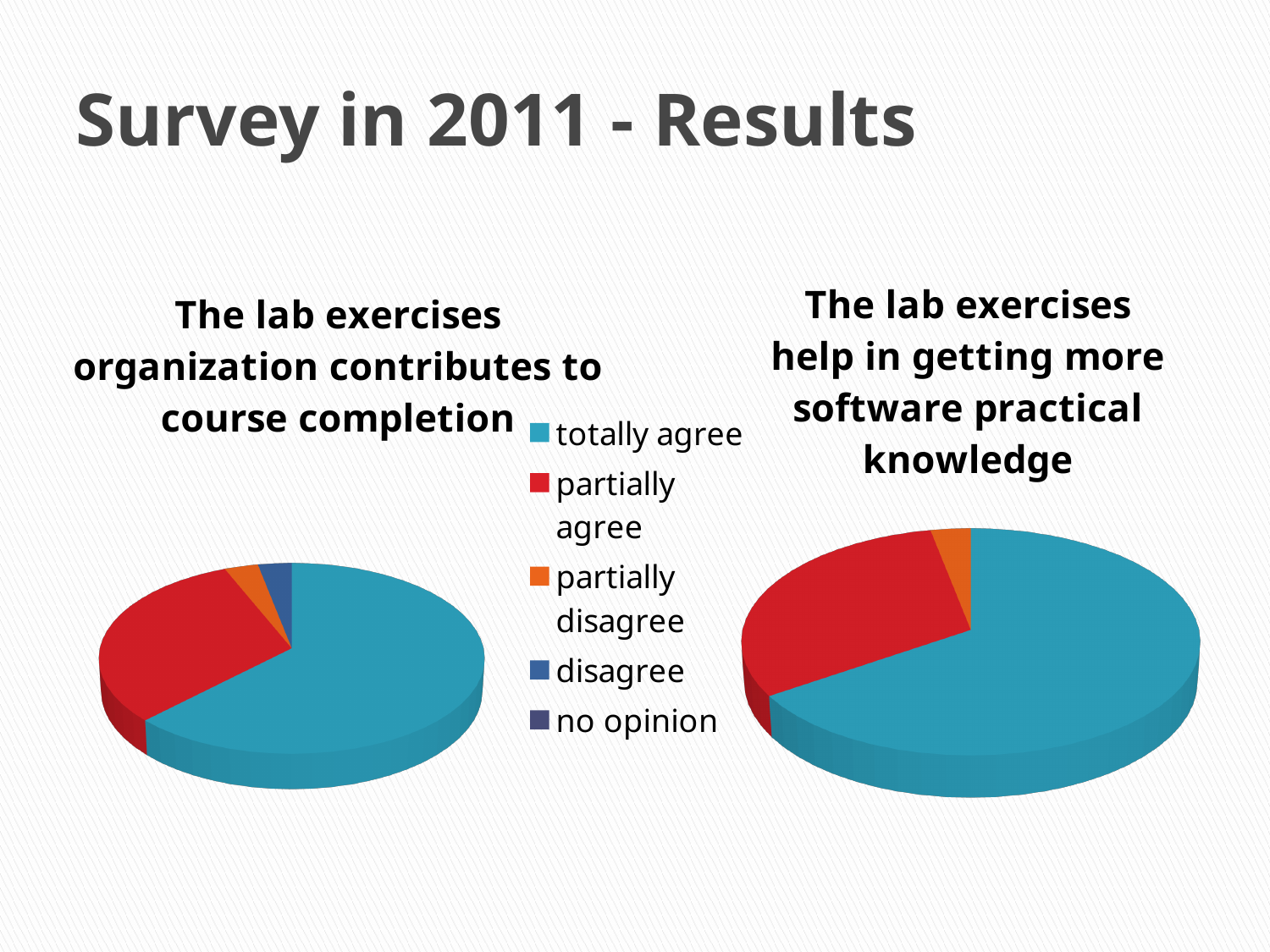
Which colour represents 'partially agree' in the legend? red In the chart 'The lab exercises organization contributes to course completion', which slice is larger: partially agree or partially disagree? partially agree What is the title of the slide? Survey in 2011 - Results How many response categories does the legend list? 5 What kind of chart is used for 'The lab exercises organization contributes to course completion'? pie chart What kind of chart is used for 'The lab exercises help in getting more software practical knowledge'? pie chart In the chart 'The lab exercises help in getting more software practical knowledge', which response category has the largest slice? totally agree In the chart 'The lab exercises help in getting more software practical knowledge', which slice is larger: totally agree or partially agree? totally agree In the chart 'The lab exercises organization contributes to course completion', which response category has the largest slice? totally agree How many slices are visible in the chart 'The lab exercises help in getting more software practical knowledge'? 3 In the chart 'The lab exercises help in getting more software practical knowledge', which visible slice is the smallest? partially disagree